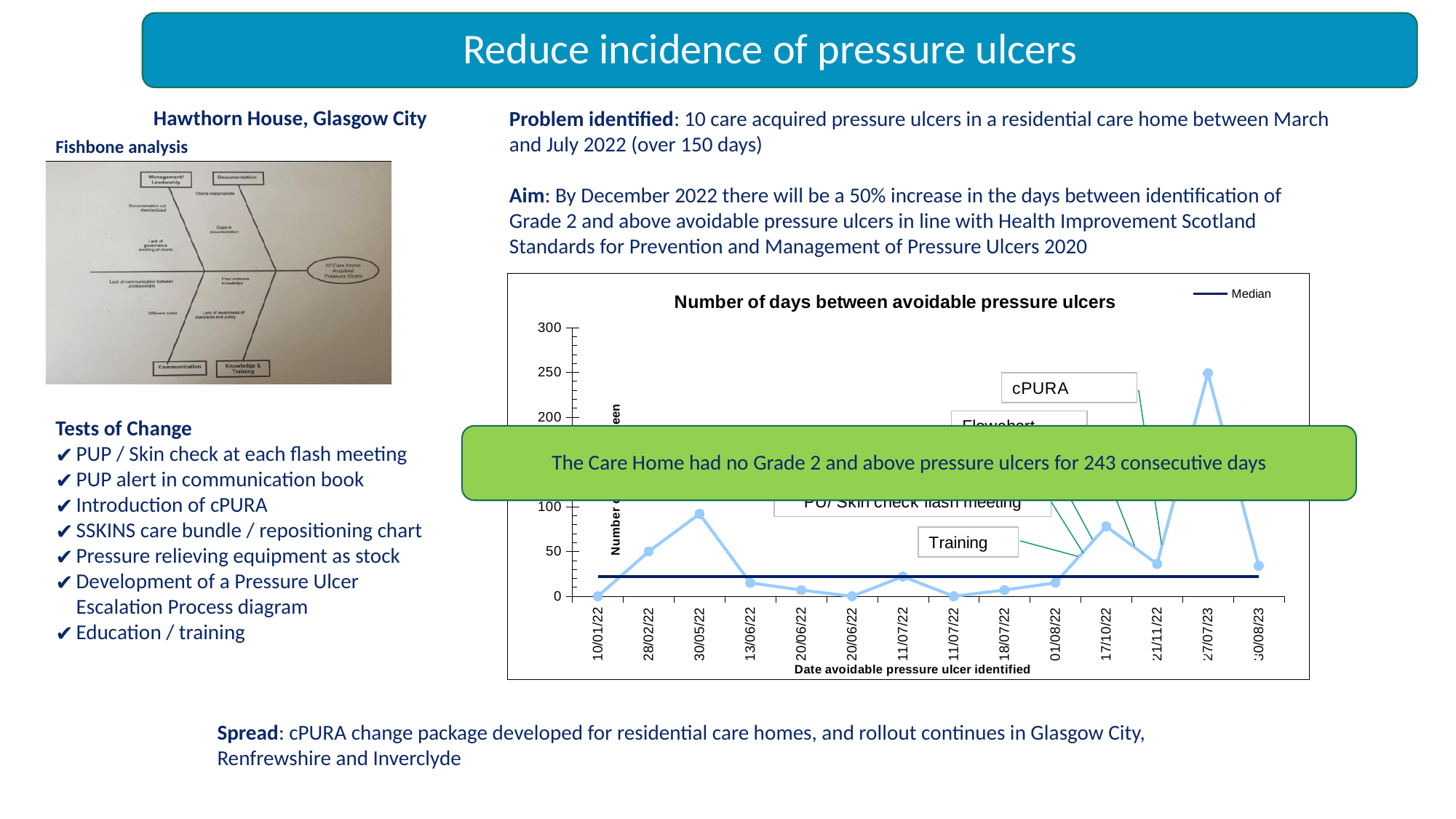
Which date has the highest number of days between avoidable pressure ulcers? 27/07/23 Which is larger, the value for 27/07/23 or the value for 30/05/22? 27/07/23 What series name appears in the chart legend? Median What is the title of the chart? Number of days between avoidable pressure ulcers Is the value for 30/08/23 greater or less than 100? less Is the value for 13/06/22 greater or less than 50? less Is the value for 30/05/22 greater or less than 50? greater What type of chart is shown on the slide? line chart How many dates are plotted along the x axis of the chart? 14 How many series does the chart legend list? 1